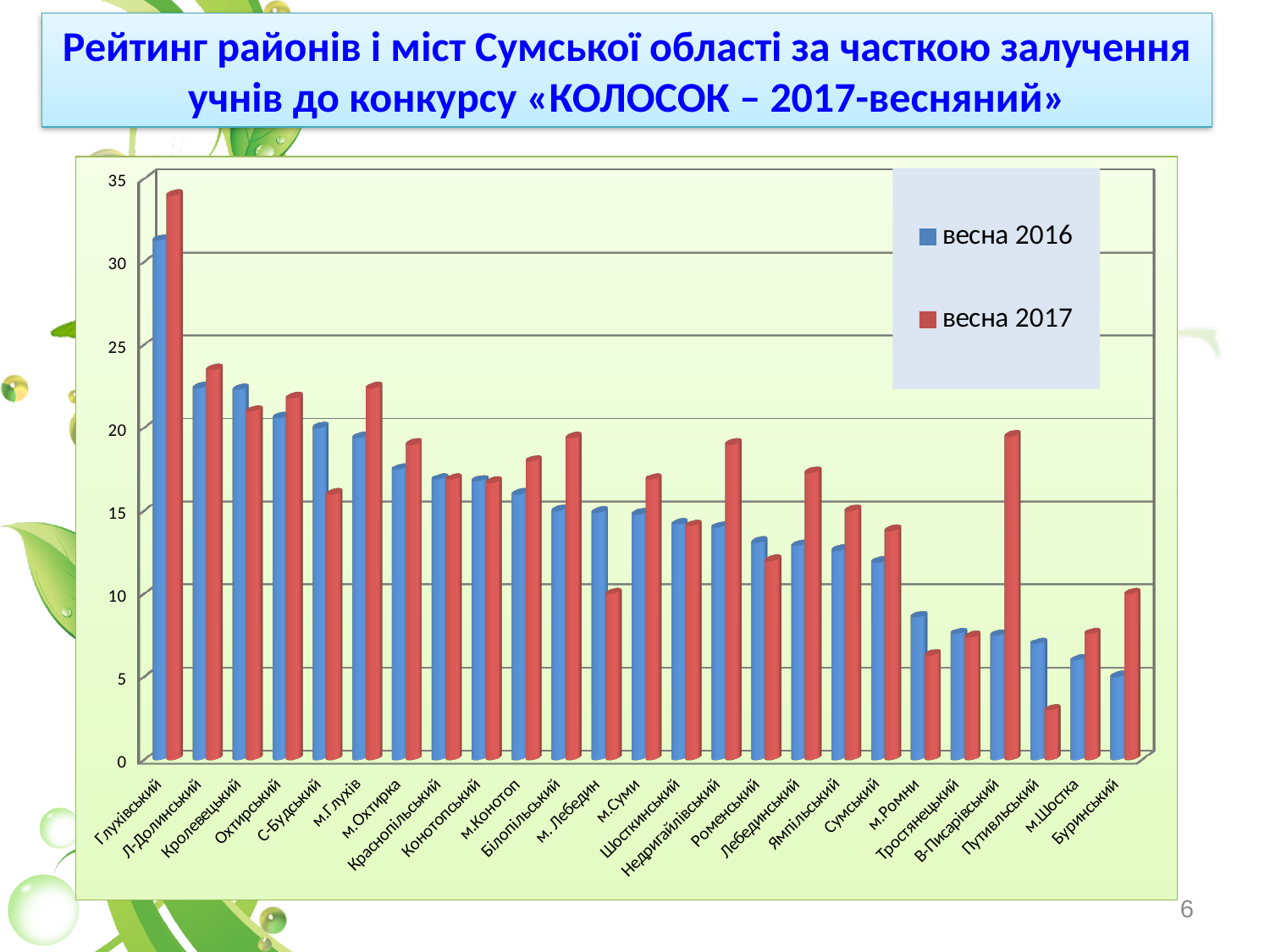
How many series does the legend list? 2 Which category has the lowest value for весна 2017? Путивльський What kind of chart is shown on the slide? bar chart Is the value for Глухівський in весна 2017 greater or less than 30? greater Is the value for Путивльський in весна 2017 greater or less than 5? less For С-Будський, which series has the larger value, весна 2016 or весна 2017? весна 2016 For В-Писарівський, which series has the larger value, весна 2016 or весна 2017? весна 2017 Do the values for весна 2016 generally rise or fall from left to right along the x axis? fall How many categories (districts and cities) are shown on the x axis? 25 Is the value for м.Глухів in весна 2017 greater or less than 20? greater Which category has the lowest value for весна 2016? Буринський Which category has the highest value for весна 2017? Глухівський